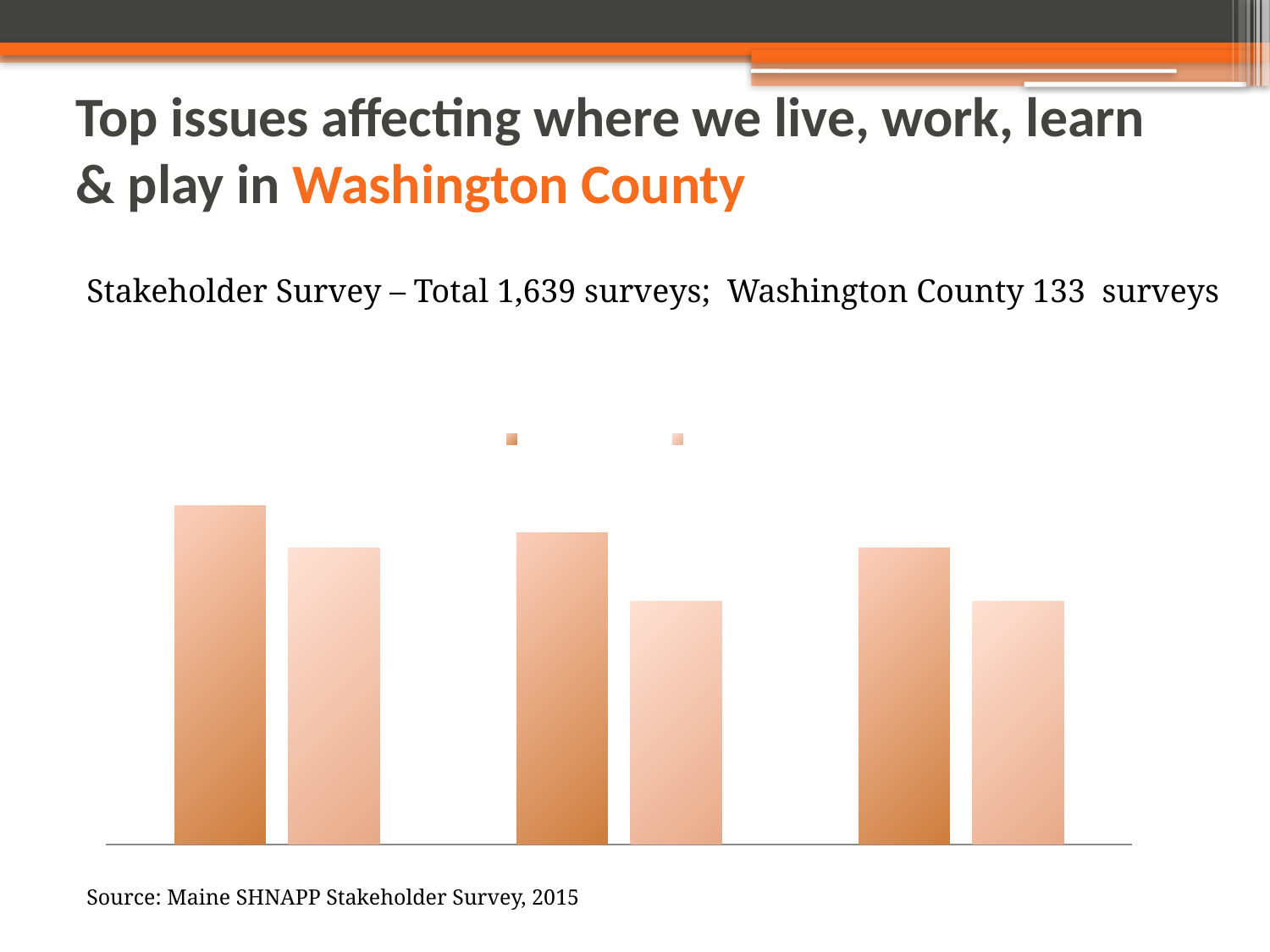
How many bars are plotted in total in the chart? 6 Are the bars in the chart vertical or horizontal? vertical In the middle group of bars, is the darker bar or the lighter bar taller? the darker bar In the rightmost group of bars, is the darker bar or the lighter bar taller? the darker bar Which group of bars contains the tallest bar in the chart: the leftmost, middle, or rightmost? the leftmost In the leftmost group of bars, is the darker bar or the lighter bar taller? the darker bar How many series does the chart's legend list? 2 What kind of chart is shown on the slide? bar chart How many groups of bars are plotted in the chart? 3 Does the darker series rise or fall from the leftmost group to the middle group? fall